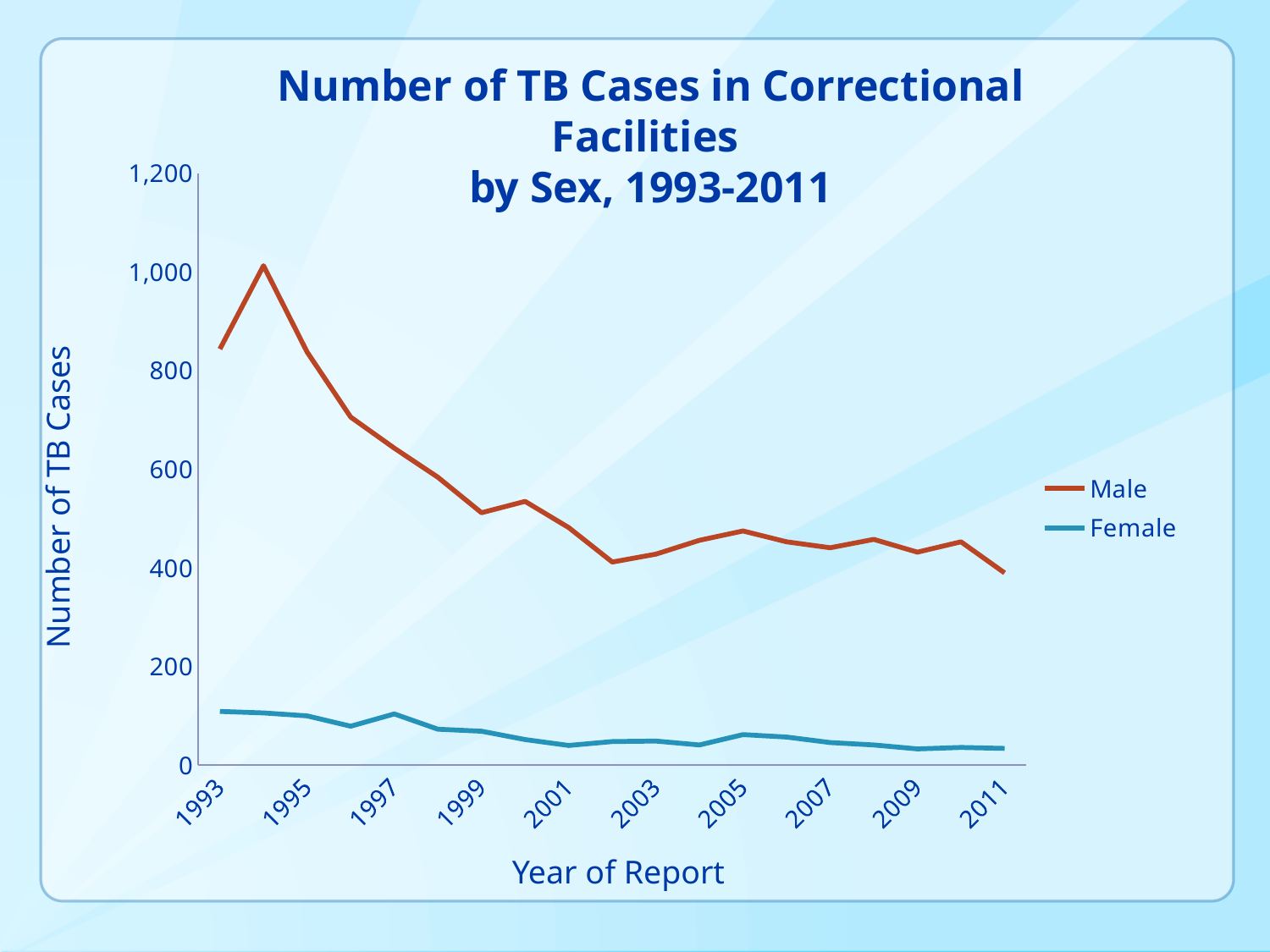
Is the Male value for 2003 greater or less than 600? less Is the Female value for 1993 greater or less than 200? less Which series has the larger value in 2005, Male or Female? Male What is the title of the chart? Number of TB Cases in Correctional Facilities by Sex, 1993-2011 Is the Male value for 1997 greater or less than 800? less Which series has the higher values across all years shown? Male What are the two series named in the legend? Male and Female How many series does the legend list? 2 Do the Male values overall rise or fall from 1993 to 2011? Fall What kind of chart is shown on the slide? Line chart